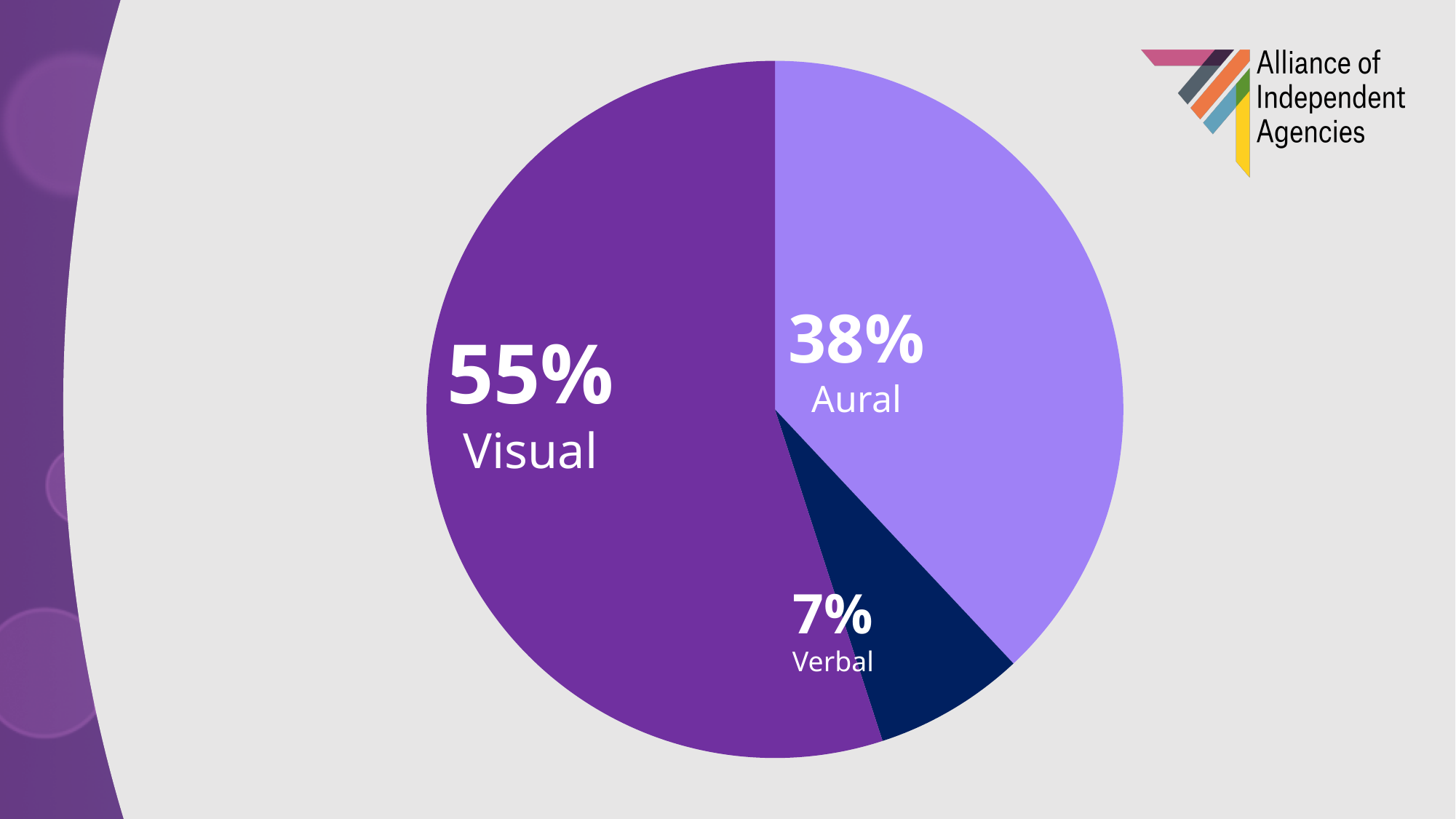
What colour is the Verbal slice? dark navy blue How many slices does the pie chart have? 3 Which slice of the pie is the largest? Visual What is the difference in percentage points between Aural and Verbal? 31 What kind of chart is shown on the slide? pie chart Which slice of the pie is the smallest? Verbal What percentage is shown for Aural? 38% What share of the pie does the Visual slice represent? 55% Which is larger, the Aural slice or the Verbal slice? Aural What percentage is shown for Verbal? 7% What percentage is shown for Visual? 55% What is the difference in percentage points between Visual and Aural? 17